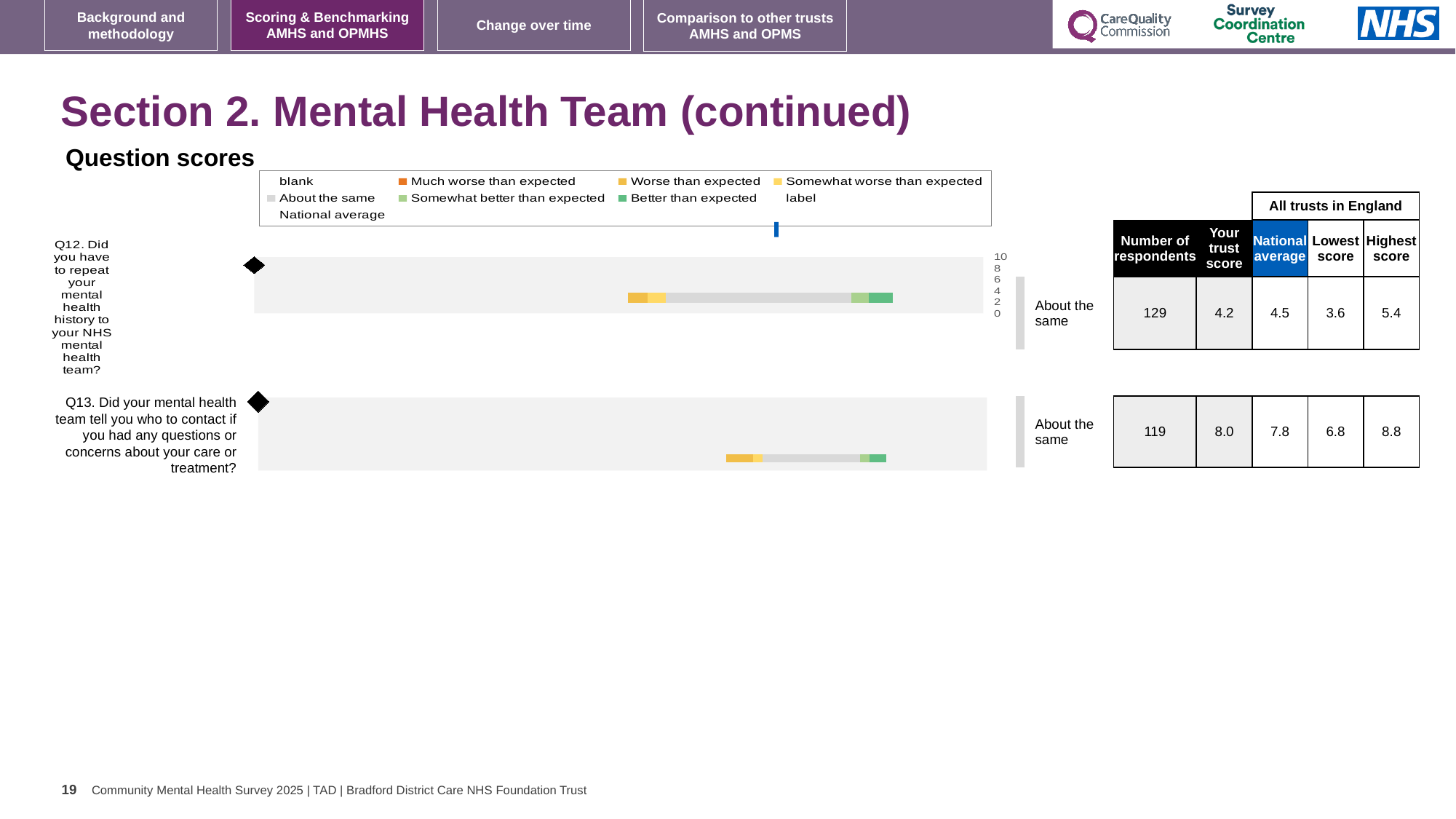
For Q12, what is the national average score? 4.5 How many questions (Q12 and Q13) are plotted on the slide? 2 For Q12, what is the number of respondents shown in the table? 129 What benchmark category label is shown next to the Q13 chart? About the same In the legend, what colour represents 'Better than expected'? green For Q12, what is your trust score? 4.2 For Q13, what is the highest score among all trusts in England? 8.8 For Q13, what is the difference between your trust score and the national average? 0.2 What kind of chart is used to show the question scores for Q12 and Q13? bar chart For Q12, which is larger: your trust score or the national average? national average For Q13, what is the lowest score among all trusts in England? 6.8 For Q13, which is larger: your trust score or the national average? your trust score